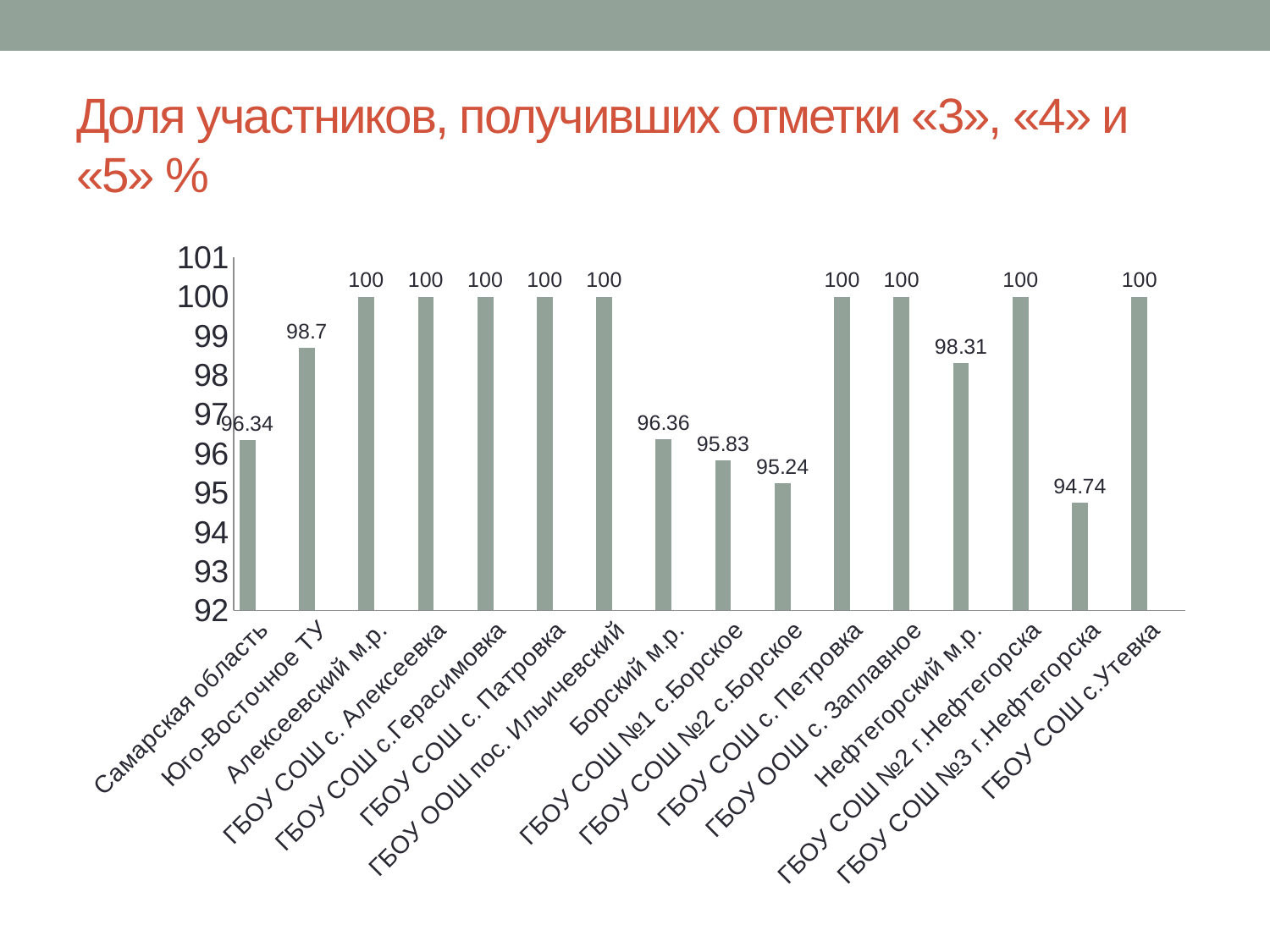
What is the value for Нефтегорский м.р.? 98.31 What is the value for ГБОУ СОШ №2 с.Борское? 95.24 What is the value for Юго-Восточное ТУ? 98.7 Which category has the lowest value? ГБОУ СОШ №3 г.Нефтегорска Is the value for ГБОУ СОШ №3 г.Нефтегорска greater or less than 96? less How many categories are shown on the x axis? 16 What kind of chart is shown on the slide? bar chart What is the difference between the values for Юго-Восточное ТУ and Самарская область? 2.36 What is the difference between the values for ГБОУ СОШ №1 с.Борское and ГБОУ СОШ №3 г.Нефтегорска? 1.09 What is the value for Самарская область? 96.34 Which is larger, the value for Борский м.р. or the value for Нефтегорский м.р.? Нефтегорский м.р. How many categories have a value of 100? 9